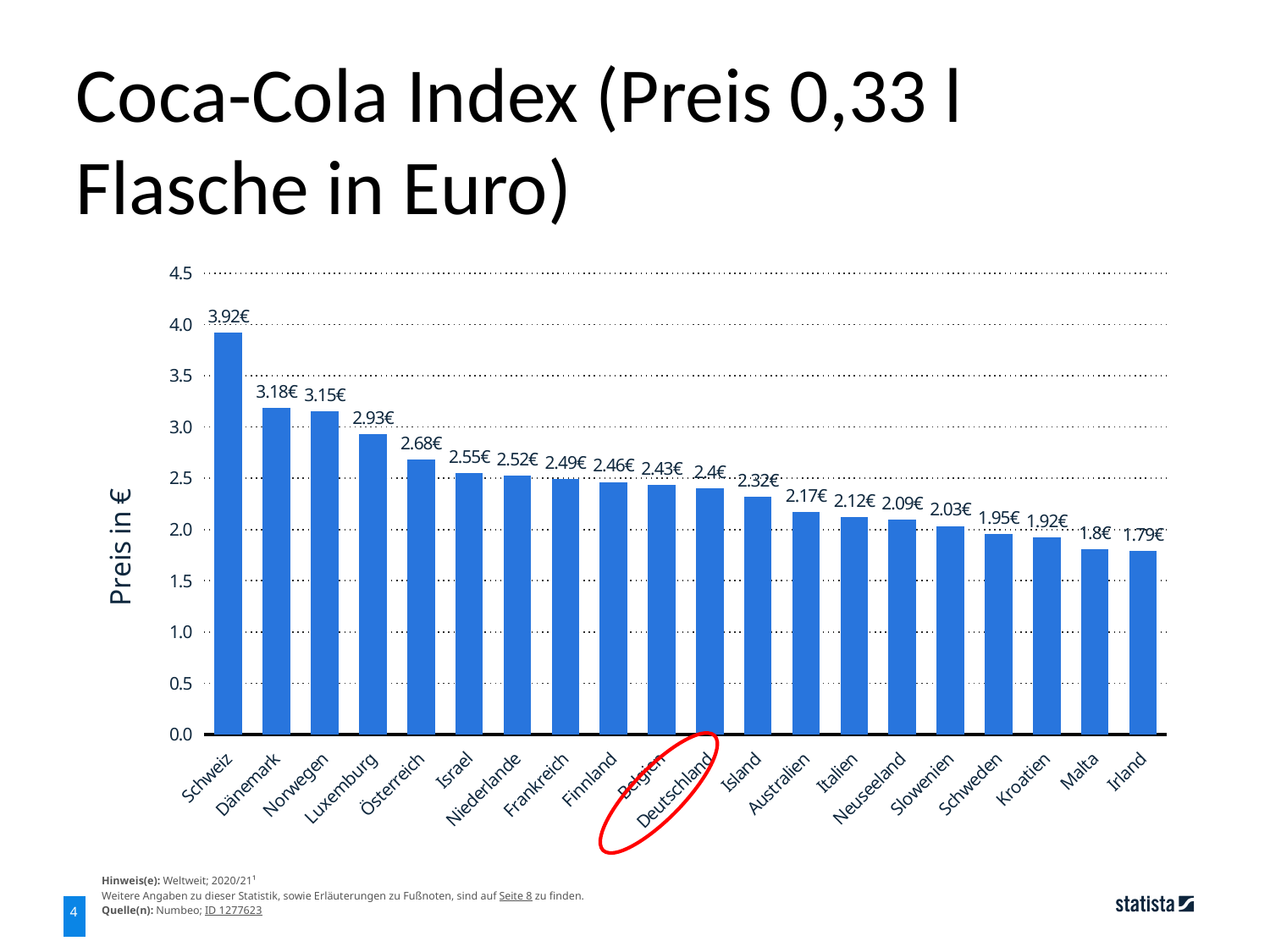
How many countries are shown in the chart? 20 Which country has the highest price? Schweiz What is the price for Deutschland? 2.4€ Which has the higher price, Dänemark or Norwegen? Dänemark What is the price for Irland? 1.79€ Do the values rise or fall from left to right along the x axis? fall What is the price for Schweiz? 3.92€ What is the difference between the price for Schweiz and the price for Irland? 2.13€ What kind of chart is shown on the slide? bar chart Which country label is circled in red on the x axis? Deutschland Which country has the lowest price? Irland Is the value for Luxemburg greater or less than 3.0? less